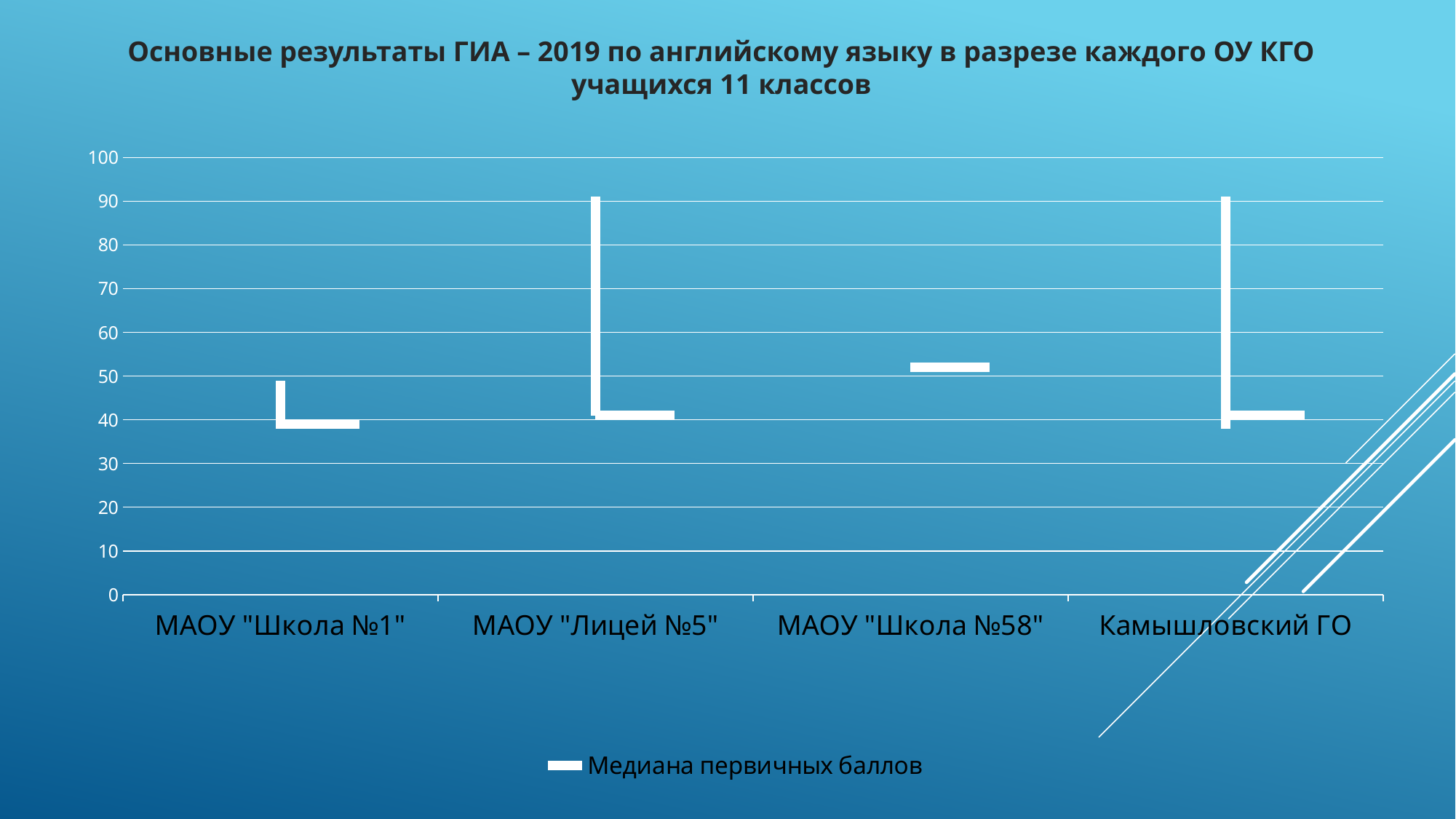
Is the horizontal marker for МАОУ "Школа №1" greater or less than 50? less How many series does the chart legend list? 1 How many categories are shown on the x axis of the chart? 4 What is the title of the chart? Основные результаты ГИА – 2019 по английскому языку в разрезе каждого ОУ КГО учащихся 11 классов What is the name of the series shown in the chart legend? Медиана первичных баллов Is the value for МАОУ "Школа №58" greater or less than 60? less Is the top of the vertical line for МАОУ "Лицей №5" greater or less than 80? greater What is the highest value shown on the vertical axis? 100